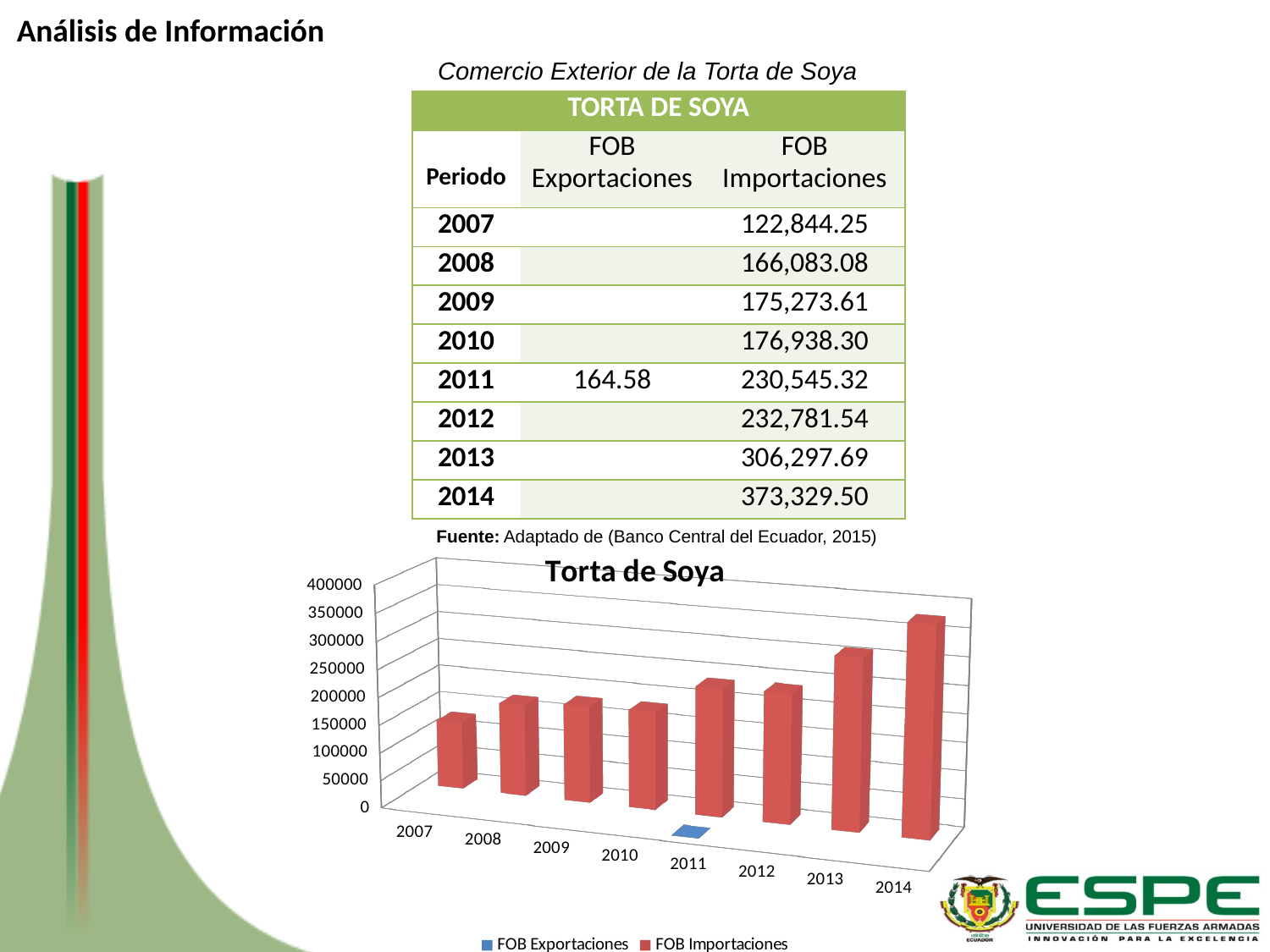
How many periods (years) are shown on the x axis of the "Torta de Soya" chart? 8 What is the FOB Exportaciones value for 2011 shown in the Torta de Soya table? 164.58 Which year has the lowest FOB Importaciones value in the "Torta de Soya" chart? 2007 How many series does the legend of the "Torta de Soya" chart list? 2 Which year has the highest FOB Importaciones value in the "Torta de Soya" chart? 2014 Do the FOB Importaciones values in the "Torta de Soya" chart generally rise or fall from 2007 to 2014? rise In the "Torta de Soya" chart, is the FOB Importaciones bar for 2007 greater or less than 150000? less In the "Torta de Soya" chart, is the FOB Importaciones bar for 2013 greater or less than 250000? greater What type of chart is shown under the title "Torta de Soya"? bar chart What is the FOB Importaciones value for 2014 shown in the Torta de Soya table? 373,329.50 What is the difference between the FOB Importaciones values for 2014 and 2013 in the Torta de Soya table? 67,031.81 In the "Torta de Soya" chart, which is larger: the FOB Importaciones bar for 2013 or for 2012? 2013